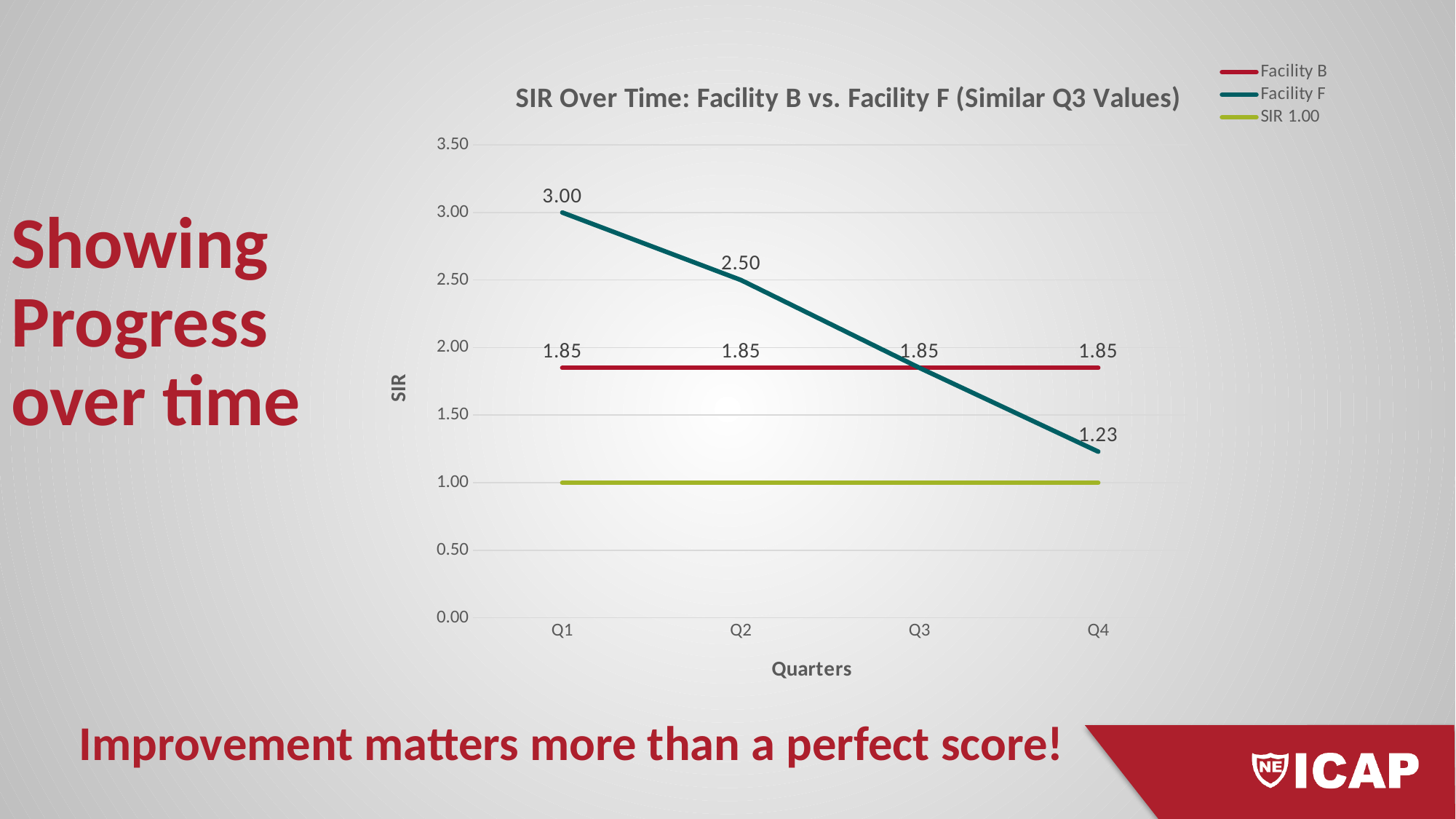
In which quarter is Facility F's SIR highest? Q1 Does Facility F's SIR rise or fall from Q1 to Q4? Fall What is the SIR value for Facility F in Q1? 3.00 In Q2, which facility has the higher SIR, Facility B or Facility F? Facility F How many series does the legend list? 3 What is the SIR value for Facility B in Q1? 1.85 What type of chart is shown on the slide? Line chart What is the SIR value for Facility F in Q2? 2.50 In which quarter is Facility F's SIR lowest? Q4 What is the difference between Facility F's SIR in Q1 and in Q4? 1.77 What is the SIR value for Facility F in Q4? 1.23 Is Facility F's SIR in Q4 greater or less than 1.50? less